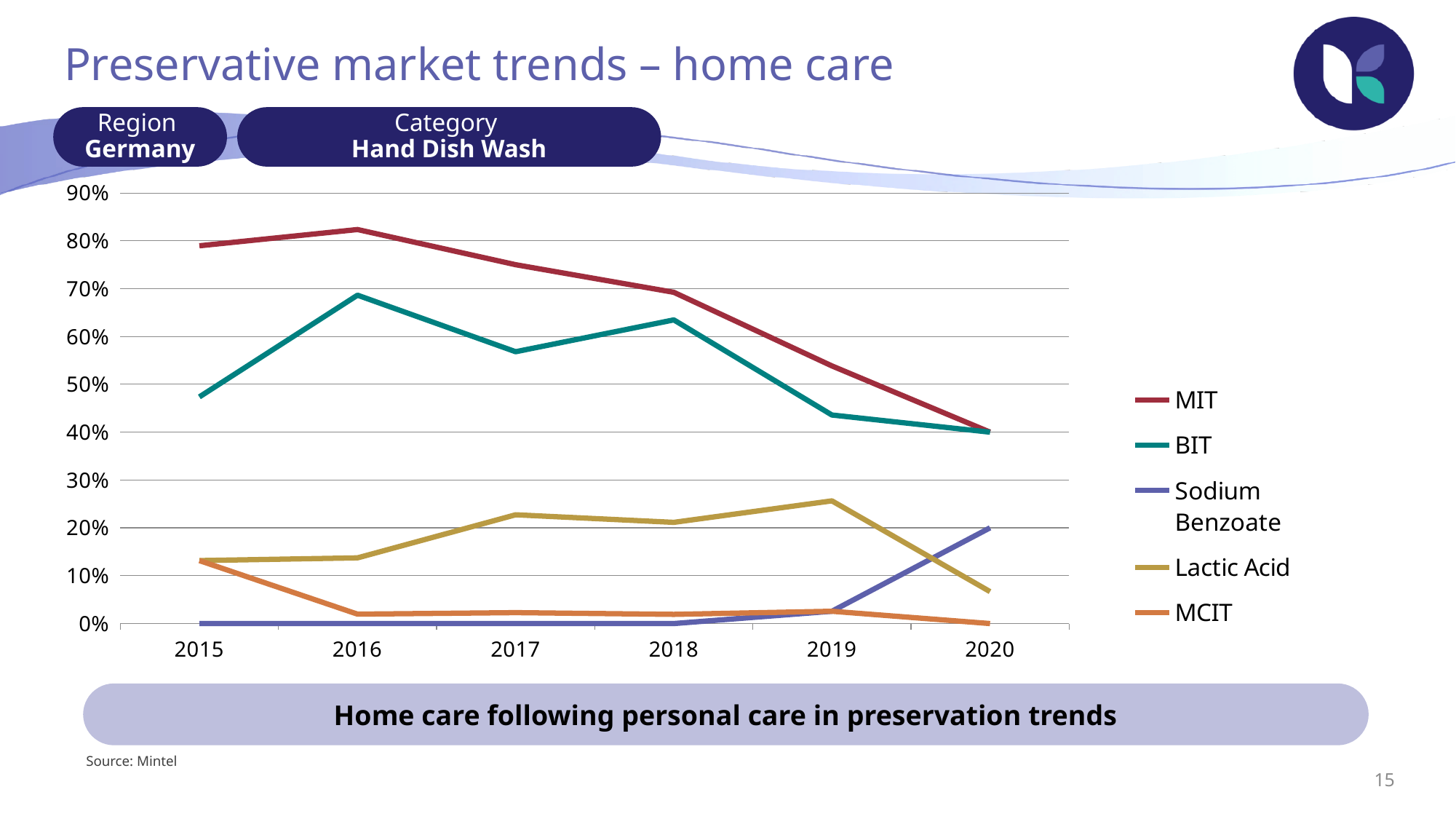
Is the value for MIT in 2016 greater or less than 80%? greater Is the value for BIT in 2015 greater or less than 50%? less In which year is Lactic Acid at its lowest? 2020 Is the value for Sodium Benzoate in 2020 greater or less than 10%? greater Does the MIT line rise or fall from 2016 to 2020? falls How many series does the legend list? 5 Does the Sodium Benzoate line rise or fall from 2018 to 2020? rises Which is larger in 2018, MIT or BIT? MIT Which series has the highest value in 2015? MIT In which year is Lactic Acid at its highest? 2019 How many years are shown on the x axis? 6 What kind of chart is shown on the slide? line chart